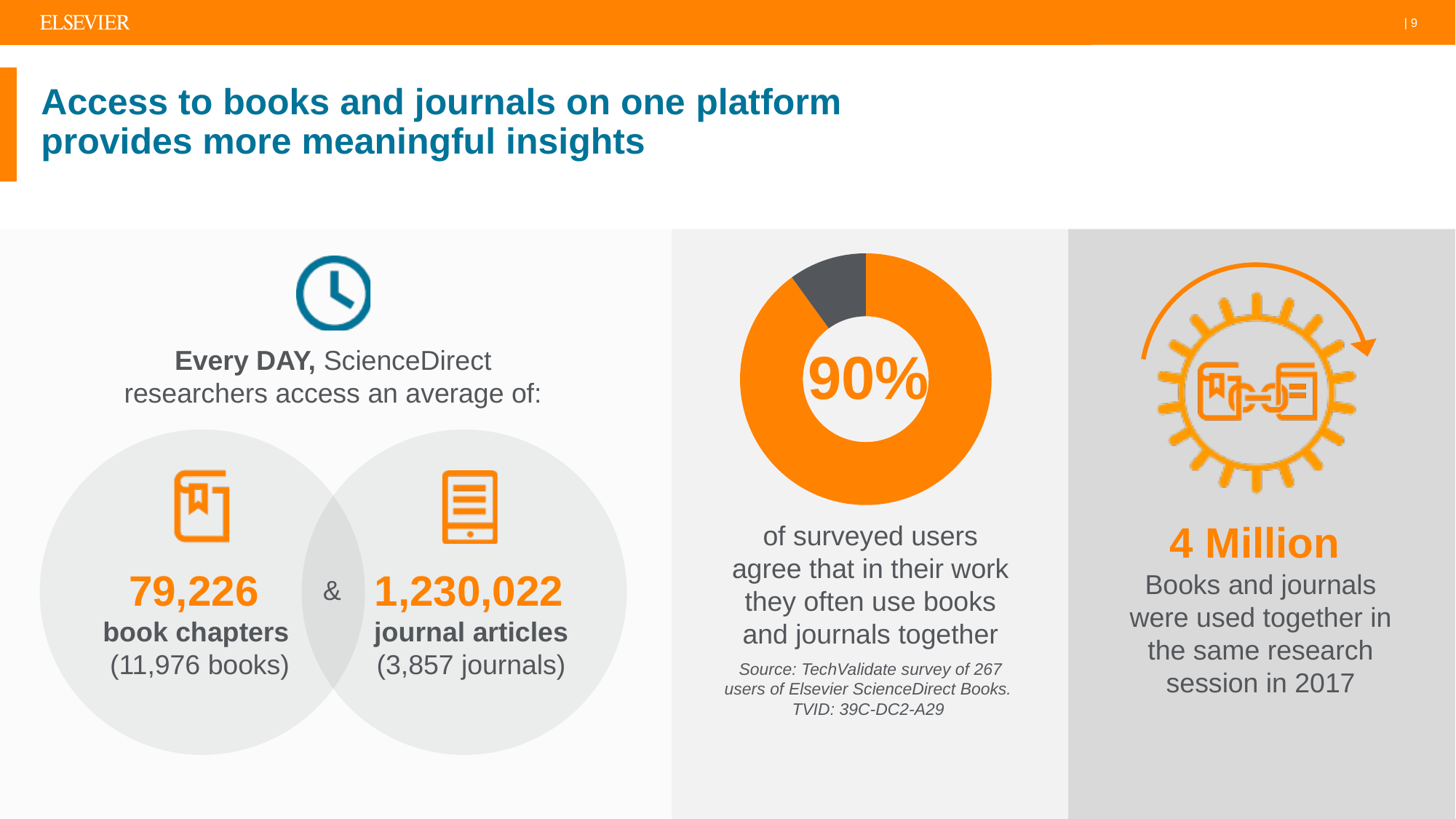
What percentage is displayed in the centre of the donut chart? 90% How many users were surveyed for the data shown in the donut chart? 267 What kind of chart is shown in the middle panel of the slide? Donut (pie) chart What share of the donut chart is taken up by the orange segment? 90% How many segments does the donut chart have? 2 According to the text below the donut chart, what does the 90% represent? Surveyed users who agree that in their work they often use books and journals together Is the value shown in the donut chart greater or less than 50%? greater Which segment of the donut chart is larger, the orange one or the dark grey one? Orange What share of the donut chart does the dark grey segment represent? 10%